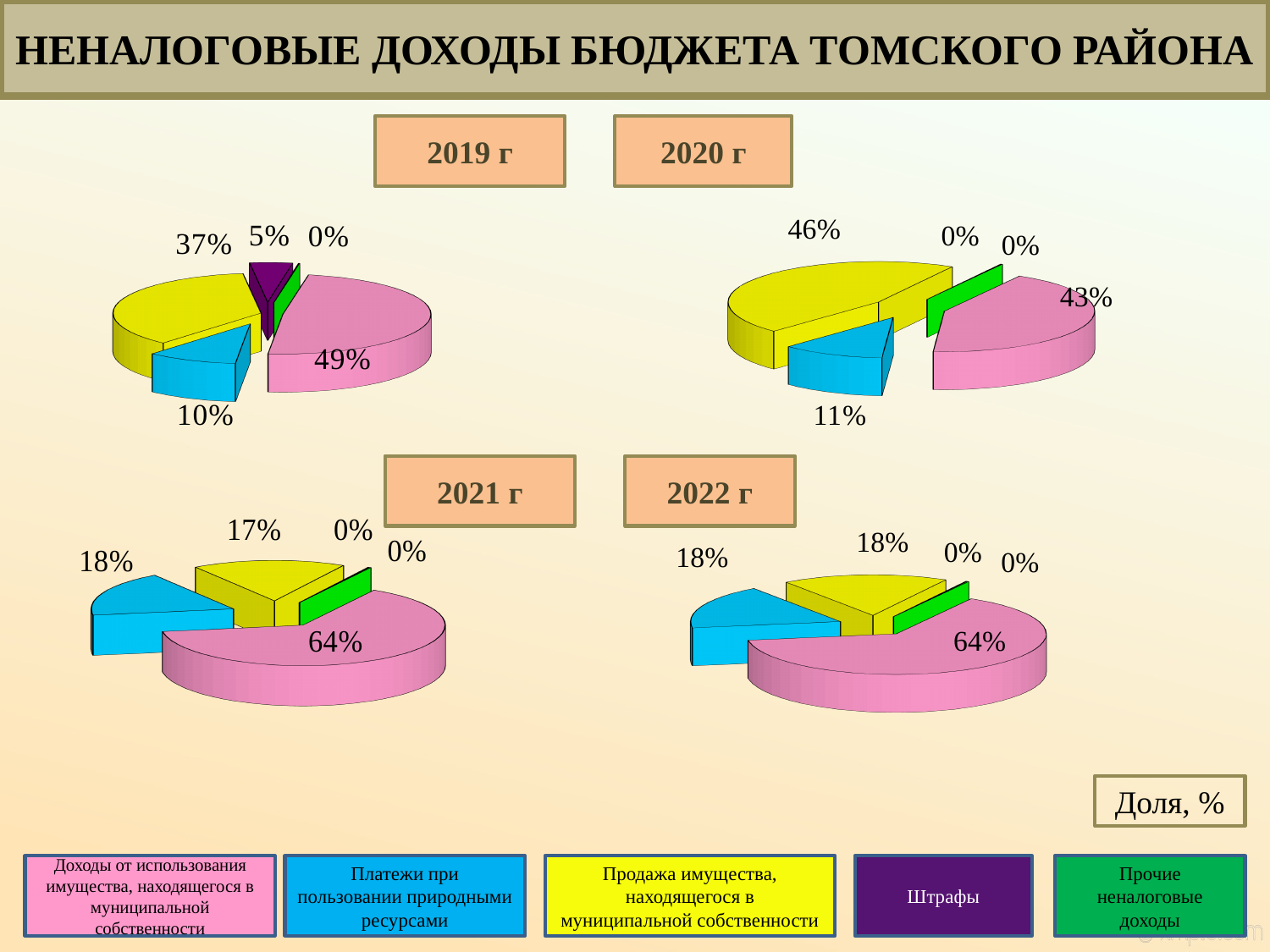
In the 2020 pie chart, which is larger: the share for sale of municipally owned property or the share for income from the use of municipally owned property? Продажа имущества, находящегося в муниципальной собственности In the 2021 pie chart, which category has the largest share? Доходы от использования имущества, находящегося в муниципальной собственности In the 2022 pie chart, what share is shown for income from the use of municipally owned property (pink slice)? 64% In the 2020 pie chart, what share is shown for sale of municipally owned property (yellow slice)? 46% In the 2019 pie chart, what is the difference between the share for income from the use of municipally owned property and the share for sale of municipally owned property? 12% In the 2020 pie chart, what share is shown for payments for the use of natural resources (blue slice)? 11% How many categories does the legend at the bottom of the slide list? 5 How many pie charts are shown on the slide? 4 In the 2019 pie chart, what share is shown for income from the use of municipally owned property (pink slice)? 49% What type of chart is used for each year on the slide? Pie chart In the 2021 pie chart, what is the difference between the share for payments for the use of natural resources and the share for sale of municipally owned property? 1% In the 2019 pie chart, what share is shown for fines (Штрафы, purple slice)? 5%